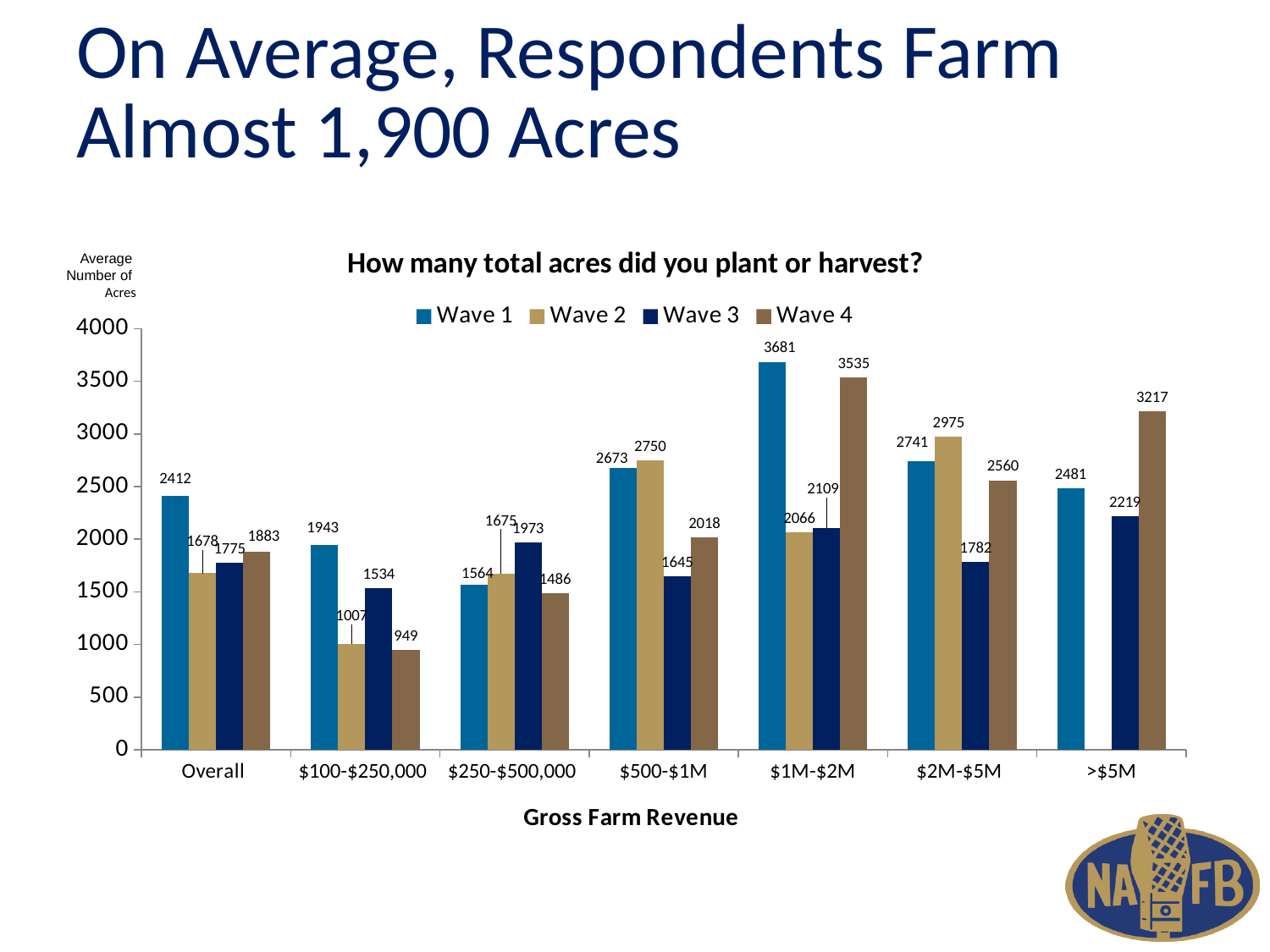
Which category has the lowest Wave 4 value? $100-$250,000 Which is larger for the >$5M category, the Wave 1 value or the Wave 4 value? Wave 4 What is the Wave 3 value for the $250-$500,000 category? 1973 What is the title of the chart? How many total acres did you plant or harvest? Which category has the highest Wave 1 value? $1M-$2M How many categories are shown on the x axis? 7 What kind of chart is shown on the slide? Bar chart What is the Wave 4 value for the $1M-$2M category? 3535 How many series does the legend list? 4 What is the Wave 2 value for the $2M-$5M category? 2975 What is the difference between the Wave 1 and Wave 2 values for the $100-$250,000 category? 936 What is the Wave 1 value for the Overall category? 2412